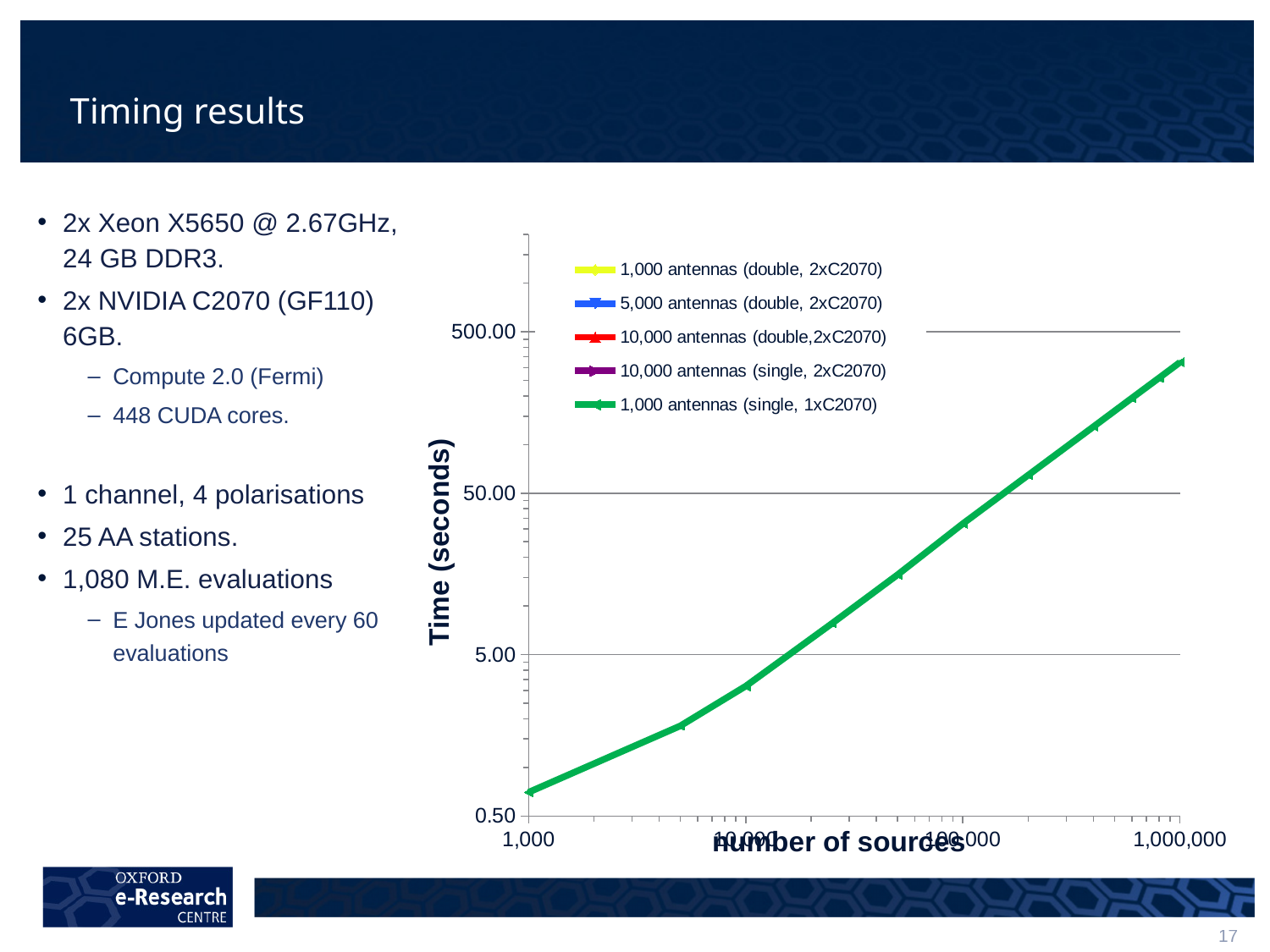
Is the value for 10,000 sources greater or less than 5.00 seconds? less Is the value for 1,000 sources greater or less than 5.00 seconds? less Which has the larger time value: 1,000 sources or 1,000,000 sources? 1,000,000 sources Do the plotted values rise or fall as the number of sources increases? rise Is the value for 1,000 sources greater or less than 0.50 seconds? greater How many series does the chart legend list? 5 What is the label of the vertical axis of the chart? Time (seconds) What is the label of the horizontal axis of the chart? Number of sources What kind of chart is shown on the slide? line chart